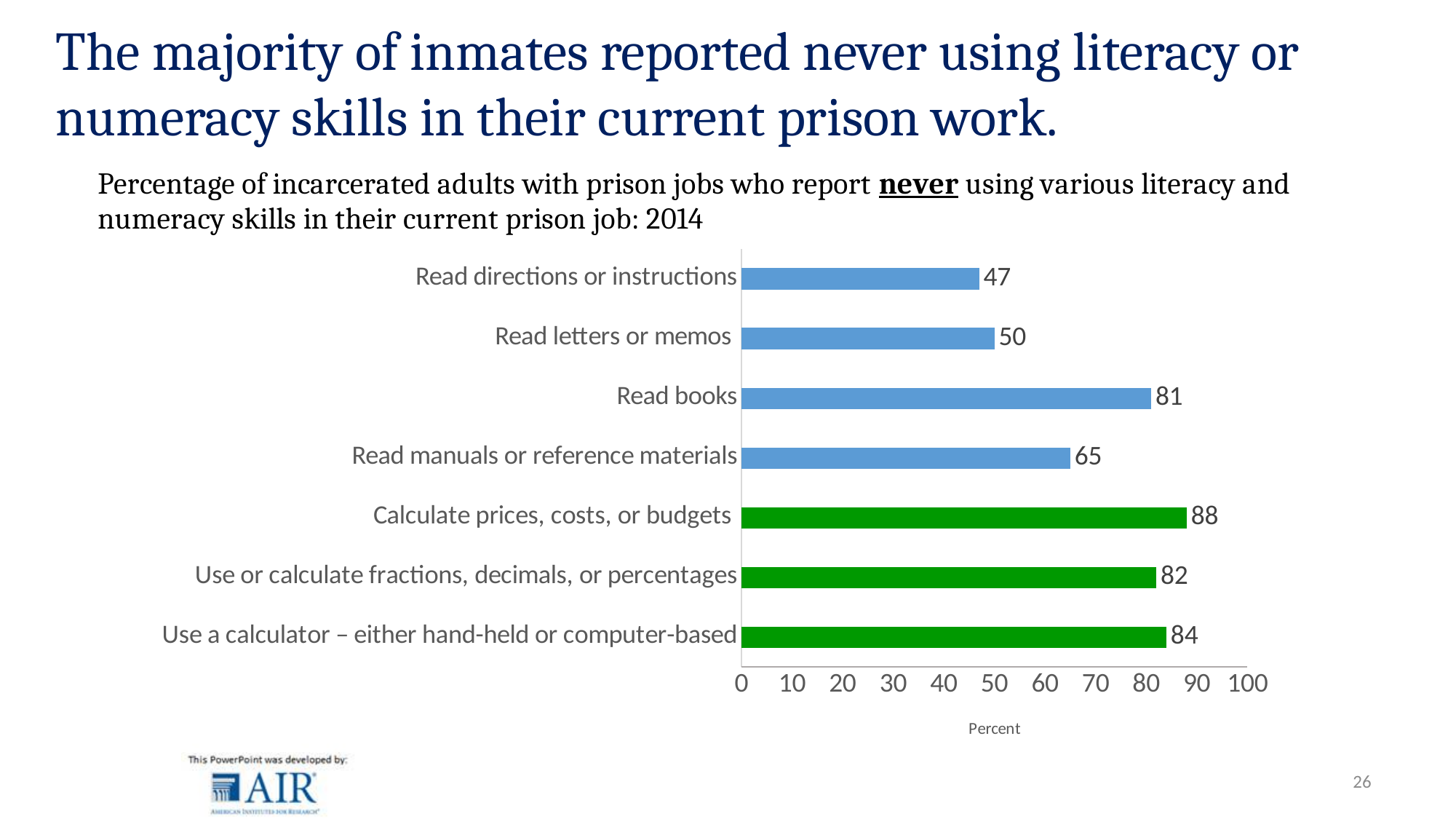
Which skill has the lowest percentage of inmates reporting never using it? Read directions or instructions What is the difference between the values for 'Calculate prices, costs, or budgets' and 'Read directions or instructions'? 41 Which is larger, the value for 'Use or calculate fractions, decimals, or percentages' or the value for 'Read manuals or reference materials'? Use or calculate fractions, decimals, or percentages What is the label on the horizontal axis of the chart? Percent How many skill categories are shown in the chart? 7 What is the difference between the values for 'Read books' and 'Read letters or memos'? 31 What percentage of incarcerated adults with prison jobs report never reading books in their current prison job? 81 What is the value for 'Read manuals or reference materials'? 65 Which skill has the highest percentage of inmates reporting never using it? Calculate prices, costs, or budgets What is the value for 'Use a calculator – either hand-held or computer-based'? 84 What kind of chart is shown on the slide? bar chart Is the value for 'Read letters or memos' greater or less than 60? less